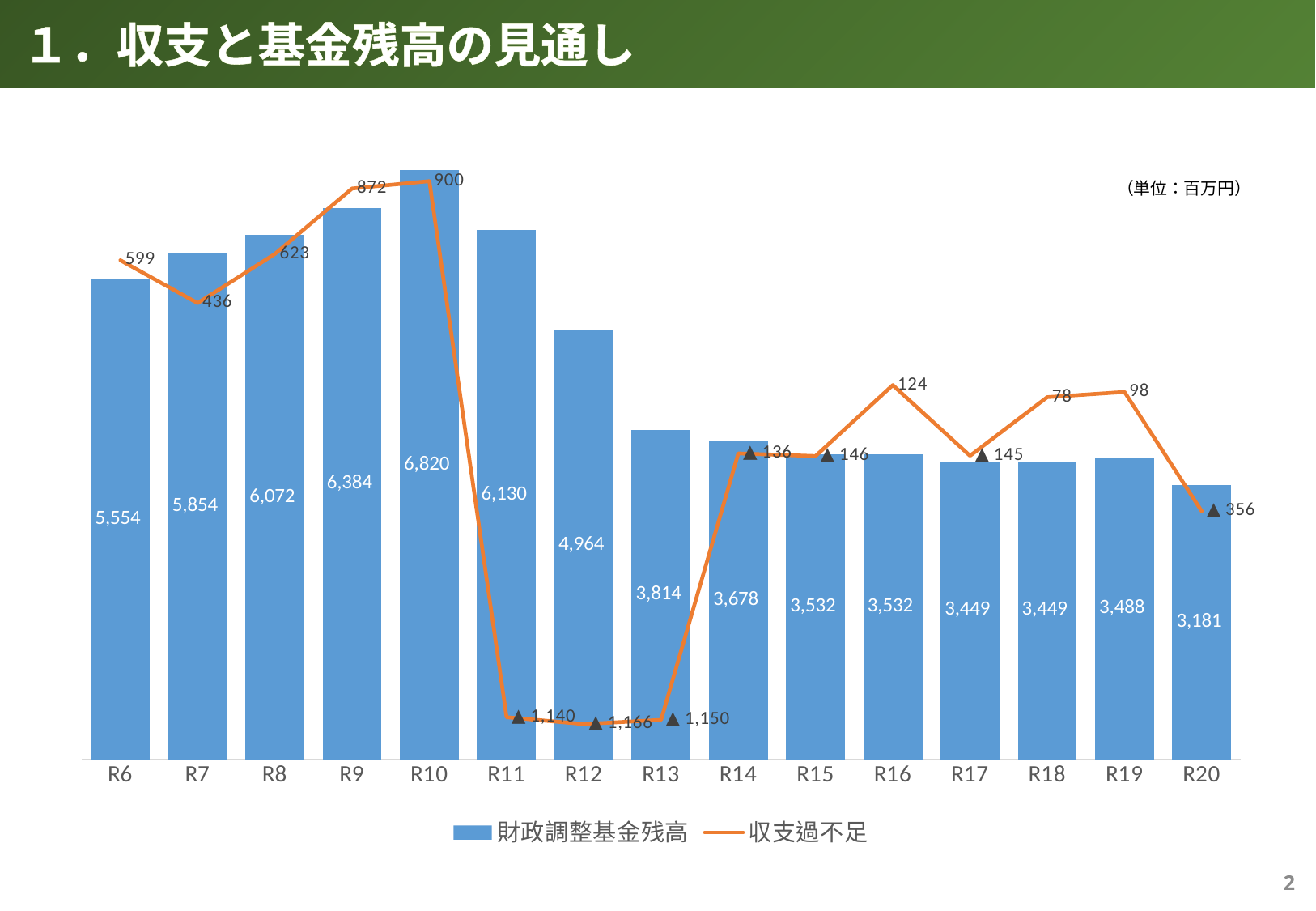
Which year has the highest 財政調整基金残高? R10 How many years are shown on the x axis? 15 How many series does the legend list? 2 Which is larger, the 財政調整基金残高 for R13 or for R14? R13 What is the value of 収支過不足 for R16? 124 What kind of chart is shown on the slide? Combined bar and line chart What is the difference in 財政調整基金残高 between R11 and R12? 1,166 What is the value of 収支過不足 for R12? ▲1,166 What unit is stated for the values on the chart? 百万円 Which year has the lowest 財政調整基金残高? R20 What is the value of 財政調整基金残高 for R20? 3,181 What is the value of 財政調整基金残高 for R10? 6,820